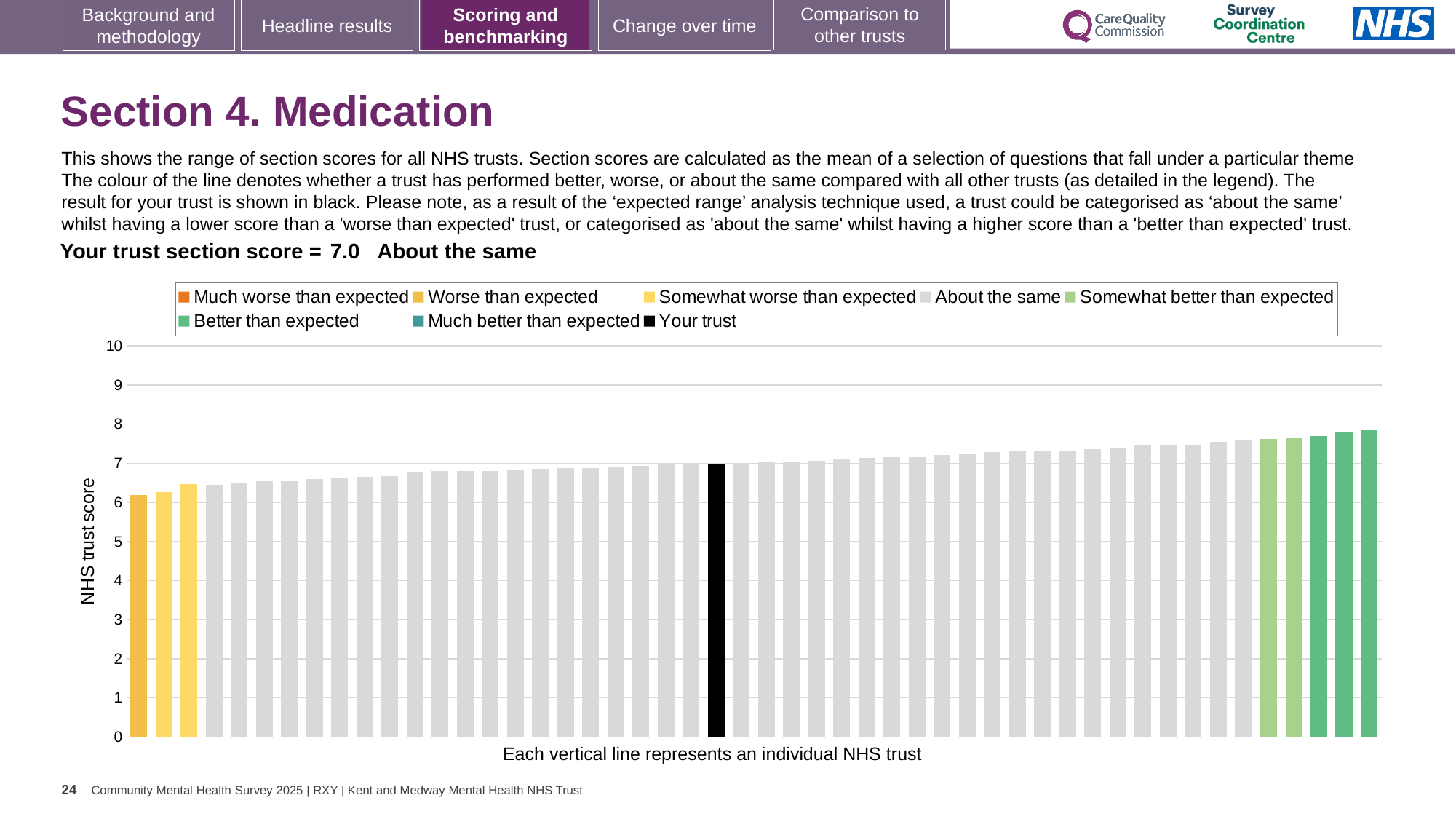
Which category is your trust placed in for this section? About the same Is the value of the highest bar greater or less than 8? less What kind of chart is shown on the slide? bar chart What is the title of the y axis? NHS trust score How many bars are coloured as 'Somewhat better than expected' (light green)? 2 Is the value of the black bar (your trust) greater or less than 5? greater Do the bar values rise or fall from left to right along the x axis? rise Is the value of the lowest bar greater or less than 6? greater What colour is the bar representing your trust? black How many entries does the chart legend list? 8 How many bars are coloured as 'Better than expected' (dark green)? 3 What is the section score for your trust? 7.0